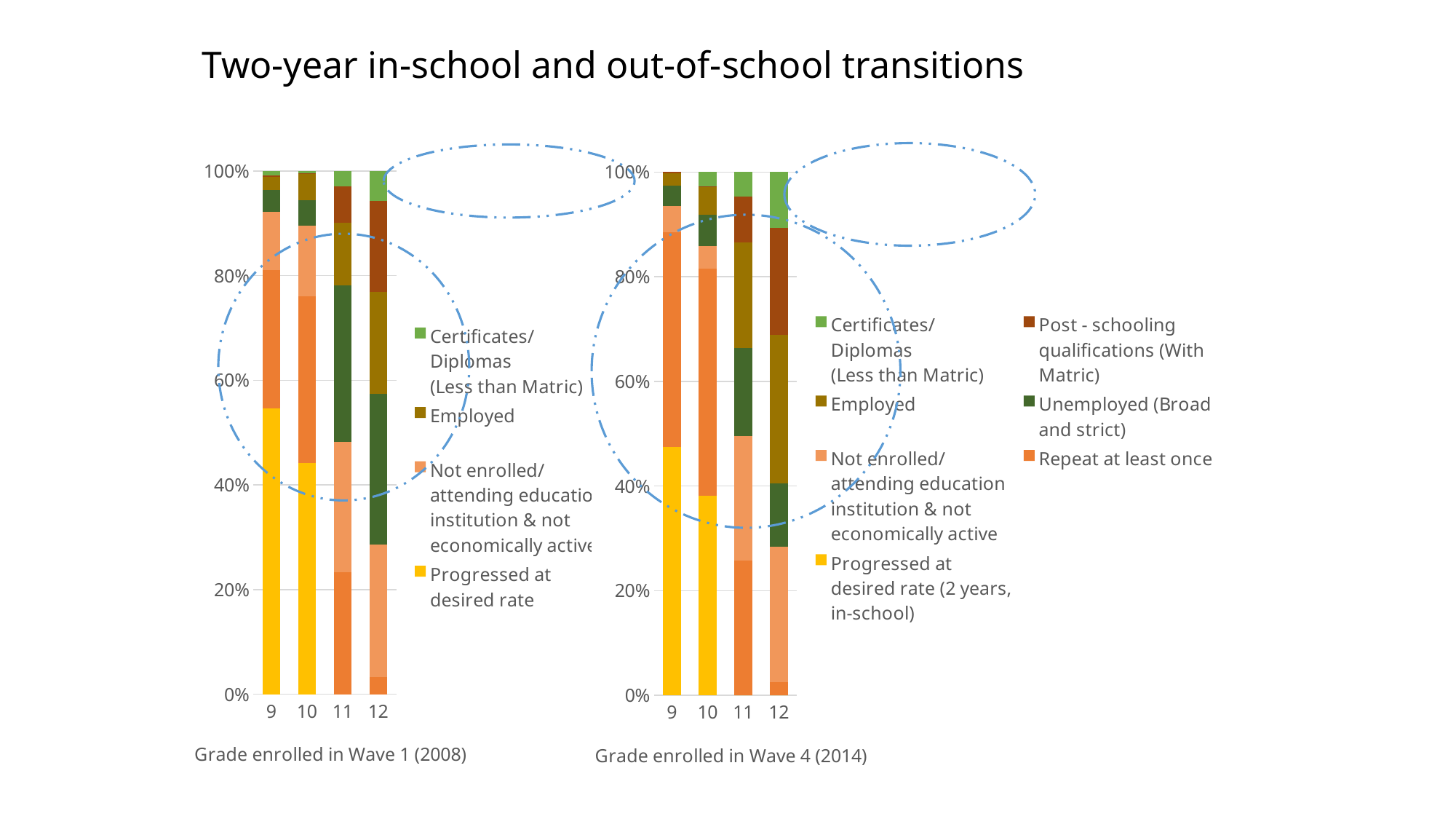
In the 'Grade enrolled in Wave 1 (2008)' chart, which grade has the largest 'Progressed at desired rate' segment? 9 What is the title of the slide containing the two charts? Two-year in-school and out-of-school transitions In the 'Grade enrolled in Wave 4 (2014)' chart, is the 'Progressed at desired rate (2 years, in-school)' share for grade 9 greater or less than 40%? greater What kind of chart is the 'Grade enrolled in Wave 1 (2008)' chart? Stacked bar chart How many grade categories are shown on the x axis of the 'Grade enrolled in Wave 4 (2014)' chart? 4 In the 'Grade enrolled in Wave 1 (2008)' chart, is the 'Progressed at desired rate' share for grade 10 greater or less than 50%? less In the 'Grade enrolled in Wave 1 (2008)' chart, is the 'Progressed at desired rate' share for grade 9 greater or less than 50%? greater In the 'Grade enrolled in Wave 1 (2008)' chart, does the 'Progressed at desired rate' segment rise or fall from grade 9 to grade 12? Fall How many series does the legend of the 'Grade enrolled in Wave 4 (2014)' chart list? 7 In the 'Grade enrolled in Wave 4 (2014)' chart, which grade has the larger 'Progressed at desired rate (2 years, in-school)' segment, grade 9 or grade 10? Grade 9